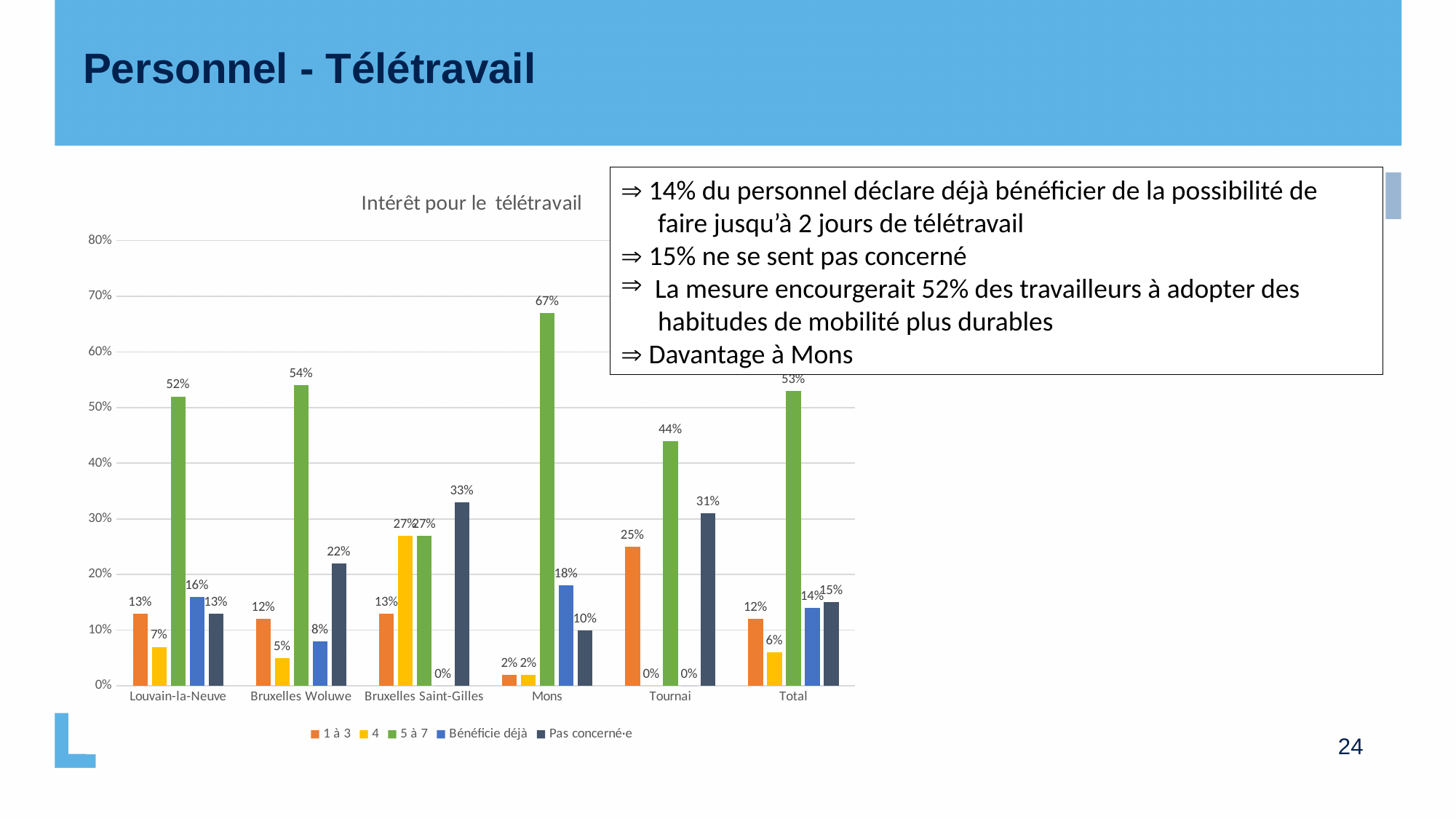
What is the value of the "Pas concerné·e" series for Bruxelles Saint-Gilles? 33% What is the difference between the "5 à 7" values for Bruxelles Woluwe and Louvain-la-Neuve? 2% Which category has the lowest value for the "5 à 7" series? Bruxelles Saint-Gilles What is the value of the "5 à 7" series for Mons? 67% Is the "5 à 7" value for Mons greater or less than 60%? greater Which category has the highest value for the "5 à 7" series? Mons What is the value of the "Bénéficie déjà" series for Total? 14% How many categories are shown on the x axis? 6 Which is larger, the "Pas concerné·e" value for Tournai or for Bruxelles Woluwe? Tournai What is the value of the "1 à 3" series for Tournai? 25% What kind of chart is shown on the slide? Bar chart How many series does the legend list? 5